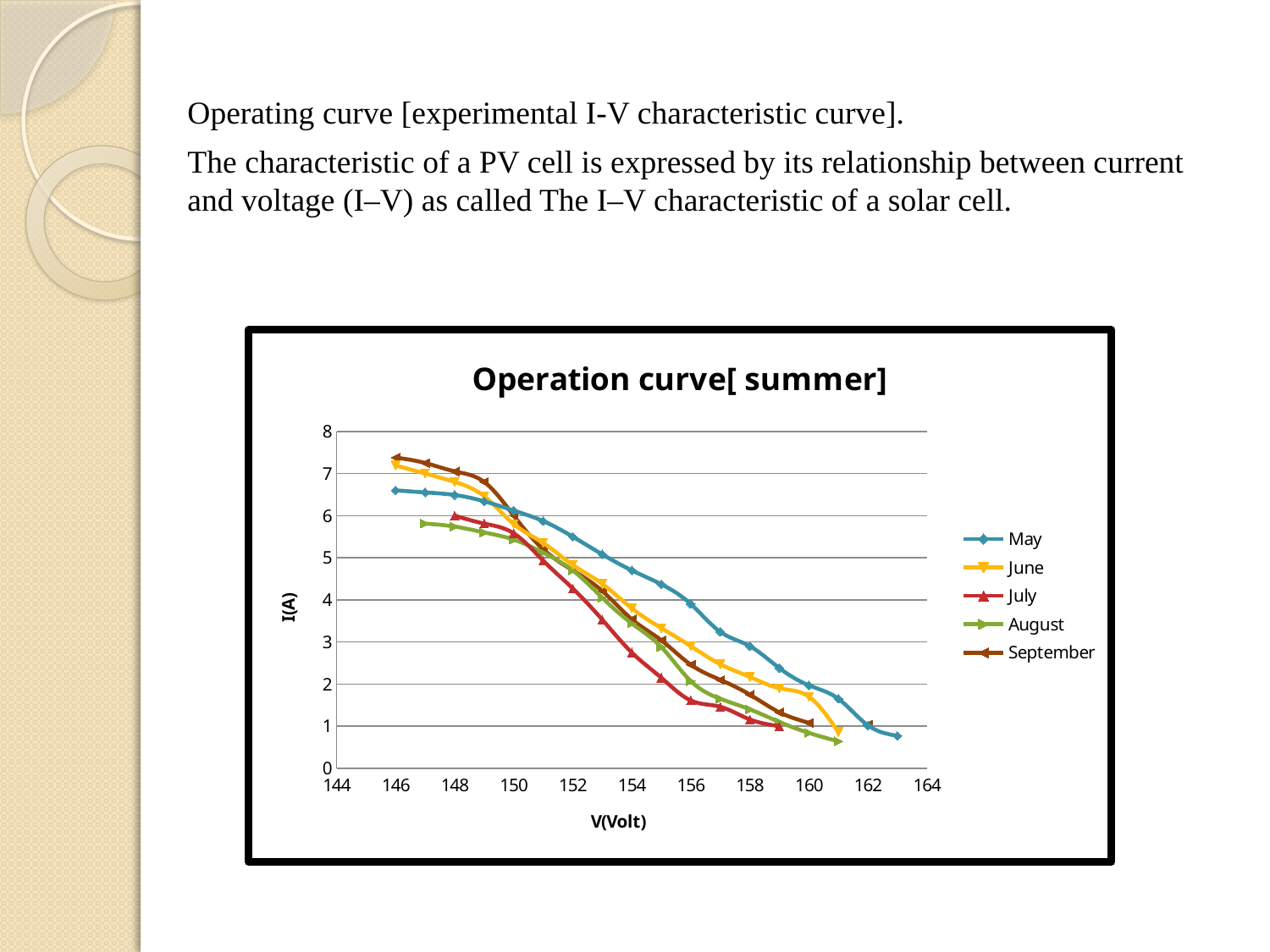
What kind of chart is shown on the slide? line chart What is the label of the x axis? V(Volt) Do the current values rise or fall as voltage increases along the x axis? fall At 156 V, which series has the higher current, May or July? May Which series extends to the highest voltage on the x axis? May Is the value for September at 146 V greater or less than 7? greater What is the title of the chart? Operation curve[ summer] Is the value for May at 163 V greater or less than 1? less At 146 V, which series has the higher current, May or September? September Is the value for May at 146 V greater or less than 6? greater How many series does the legend list? 5